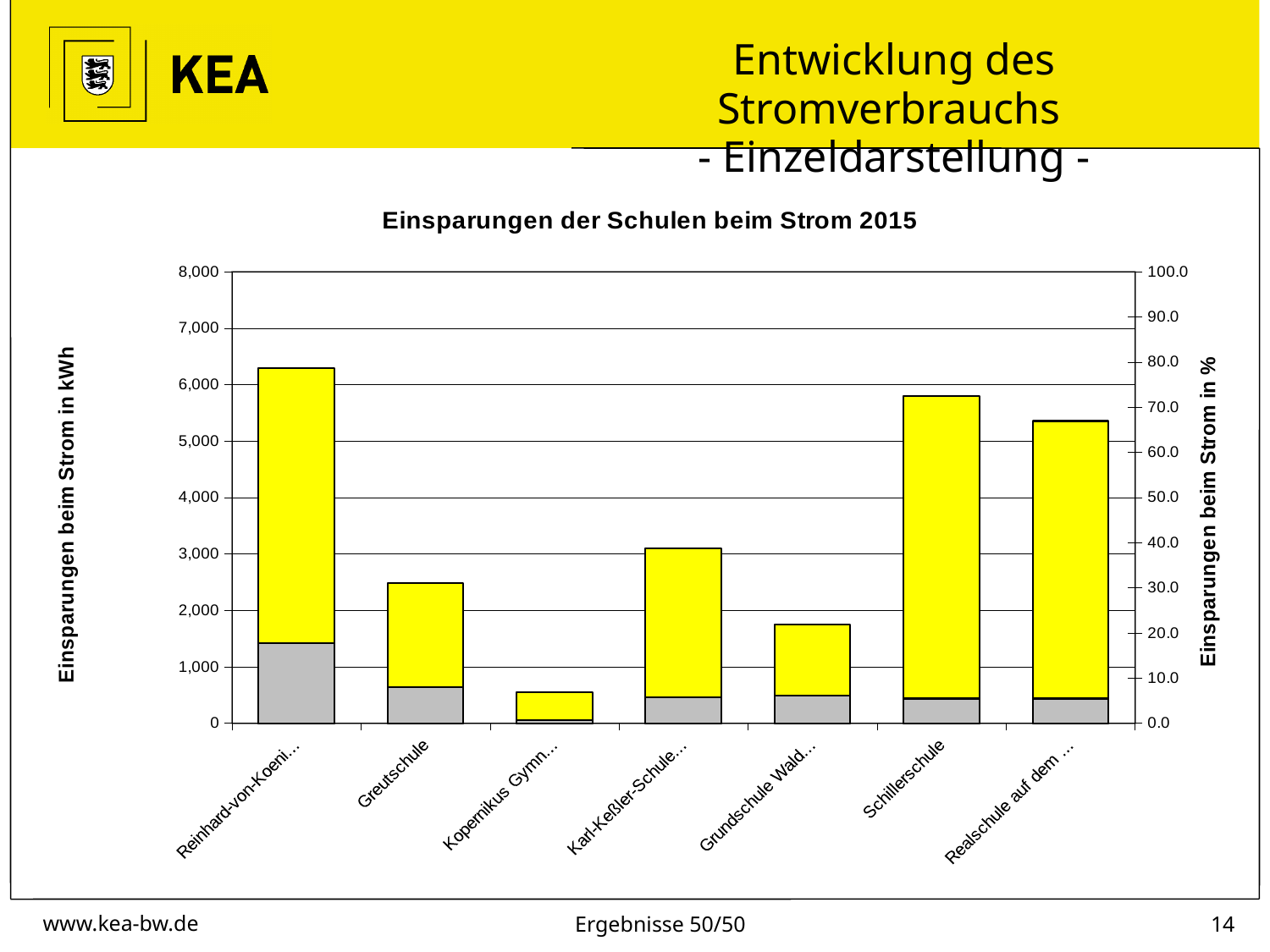
How many schools (categories) are shown on the x axis of the chart? 7 Is the yellow bar for Kopernikus Gymn... greater or less than 1,000 kWh? less Is the yellow bar for Grundschule Wald... greater or less than 2,000 kWh? less Is the yellow bar for Schillerschule greater or less than 5,000 kWh? greater What is the title of the left vertical axis? Einsparungen beim Strom in kWh Which school has the shortest yellow bar (lowest savings in kWh)? Kopernikus Gymn... Which school has the tallest yellow bar (highest savings in kWh)? Reinhard-von-Koeni... Which has the taller yellow bar, Schillerschule or Realschule auf dem ...? Schillerschule Which has the taller yellow bar, Greutschule or Grundschule Wald...? Greutschule What kind of chart is shown on the slide? bar chart What is the title of the chart? Einsparungen der Schulen beim Strom 2015